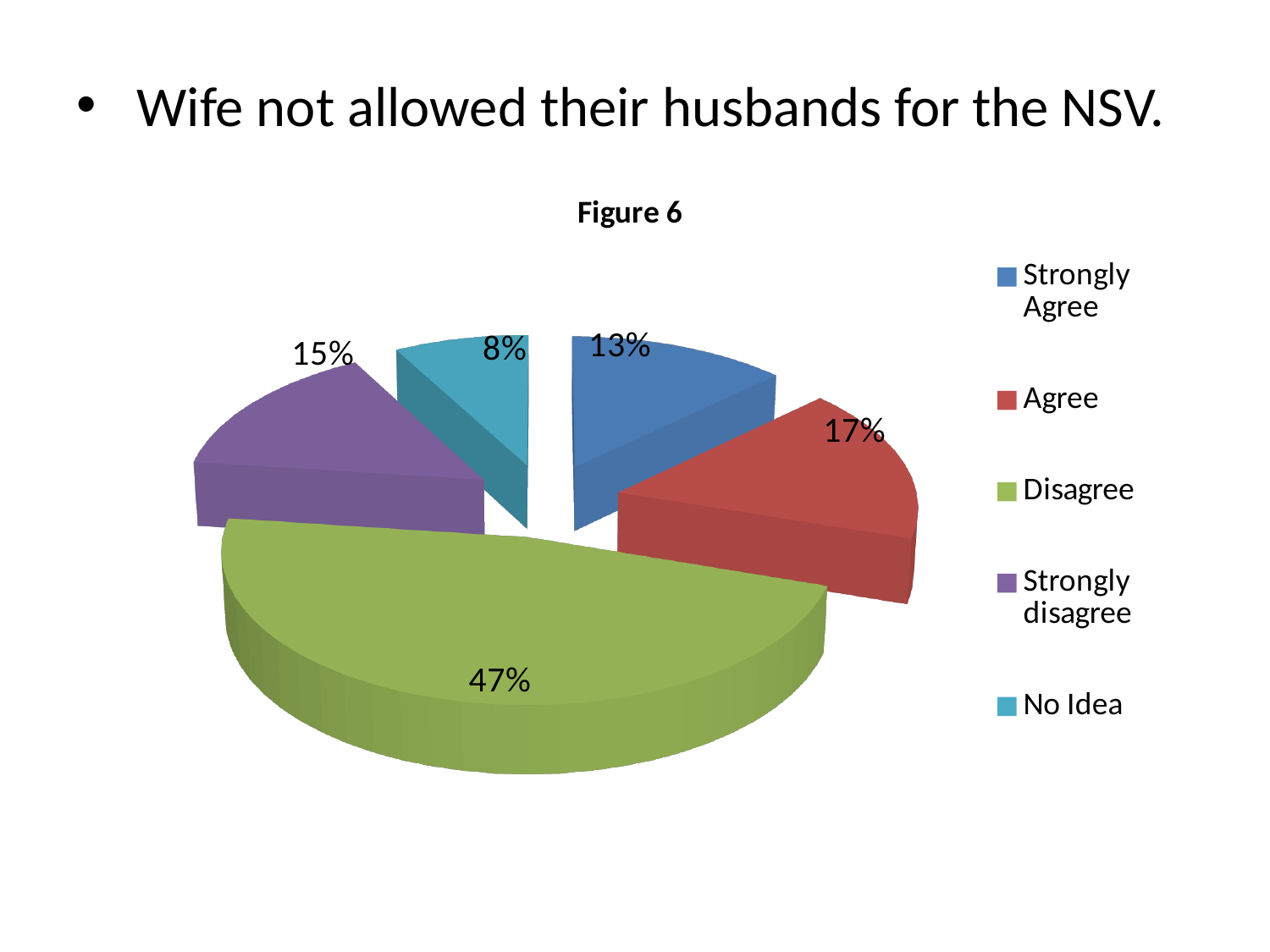
What colour is the Disagree slice? green What is the chart's title? Figure 6 What percentage of the pie is labelled Disagree? 47% What percentage of the pie is labelled Strongly Agree? 13% How many categories does the legend list? 5 What percentage of the pie is labelled No Idea? 8% Which category has the largest share of the pie? Disagree Which category has the smallest share of the pie? No Idea What is the difference in percentage points between Disagree and Agree? 30 Which is larger, the share for Agree or the share for Strongly disagree? Agree What percentage of the pie is labelled Strongly disagree? 15% What kind of chart is shown on the slide? pie chart